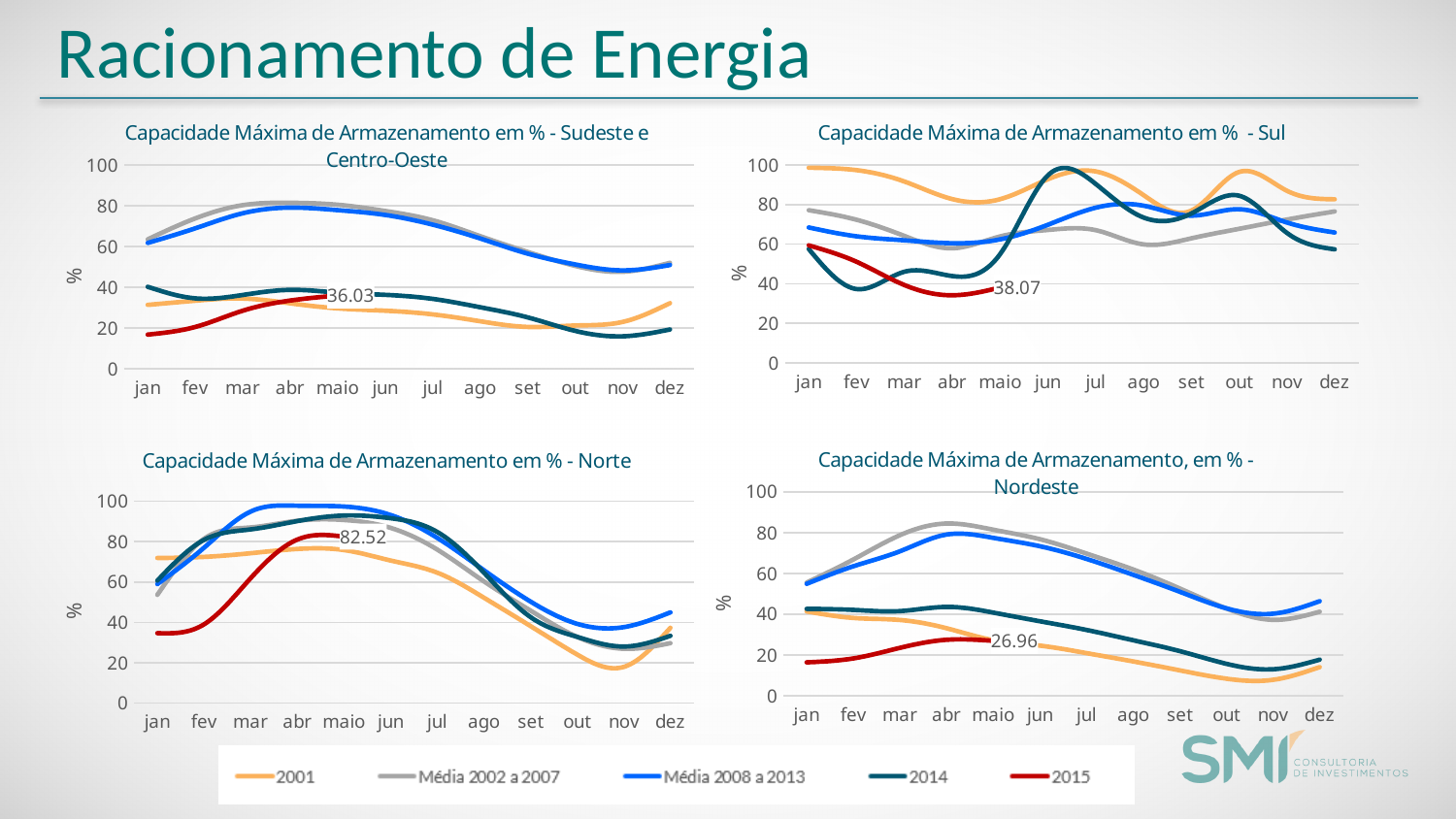
How many months are shown on the x axis of the 'Capacidade Máxima de Armazenamento em % - Norte' chart? 12 In the 'Capacidade Máxima de Armazenamento em % - Norte' chart, what value is labeled on the 2015 line in maio? 82.52 In the 'Capacidade Máxima de Armazenamento, em % - Nordeste' chart, what value is labeled on the 2015 line in maio? 26.96 In the 'Capacidade Máxima de Armazenamento, em % - Nordeste' chart, which series is higher in abr: Média 2002 a 2007 or 2015? Média 2002 a 2007 In the 'Capacidade Máxima de Armazenamento em % - Sul' chart, is the value for 2001 in jan greater or less than 80? greater In the 'Capacidade Máxima de Armazenamento em % - Sul' chart, what value is labeled on the 2015 line in maio? 38.07 How many series does the shared legend at the bottom of the slide list? 5 In the 'Capacidade Máxima de Armazenamento, em % - Nordeste' chart, does the 2001 line rise or fall from jan to nov? fall In the 'Capacidade Máxima de Armazenamento em % - Sudeste e Centro-Oeste' chart, what value is labeled on the 2015 line in maio? 36.03 In the 'Capacidade Máxima de Armazenamento, em % - Nordeste' chart, is the value for 2001 in nov greater or less than 20? less What kind of chart is the 'Capacidade Máxima de Armazenamento em % - Sul' chart? line chart Across the four charts, which region has the highest labeled 2015 value in maio? Norte